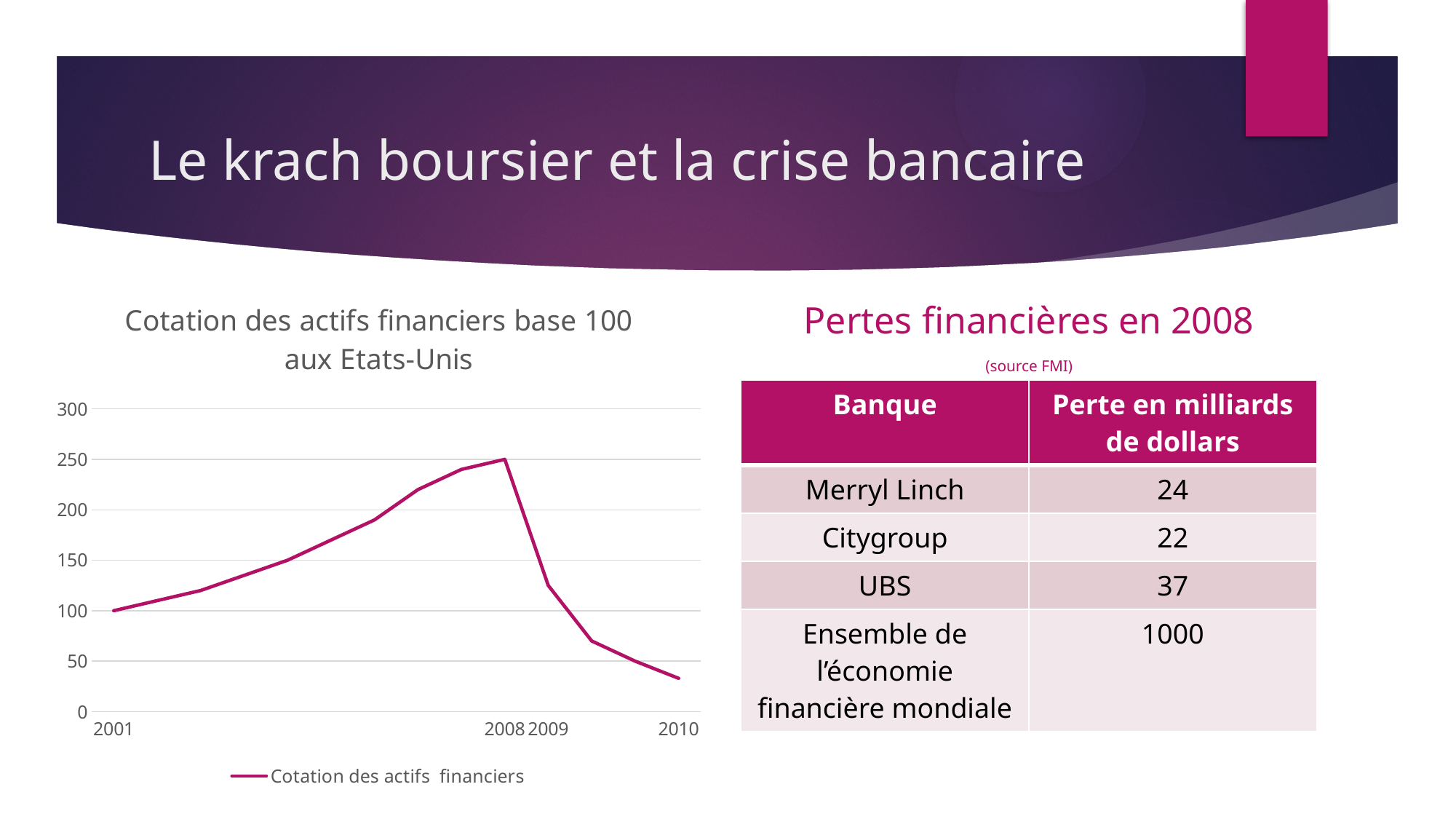
Is the value for 2009 greater or less than 150? less By how much does the value increase between 2001 and 2008? 150 What is the value of the series in 2001? 100 Is the value for 2010 greater or less than 50? less In which labelled year does the series reach its lowest value? 2010 What is the name of the series shown in the chart's legend? Cotation des actifs financiers What is the value of the series in 2008? 250 What is the title of the chart on the slide? Cotation des actifs financiers base 100 aux Etats-Unis What kind of chart is shown on the slide? line chart In which labelled year does the series reach its highest value? 2008 Does the series rise or fall between 2008 and 2010? fall How many series does the chart's legend list? 1